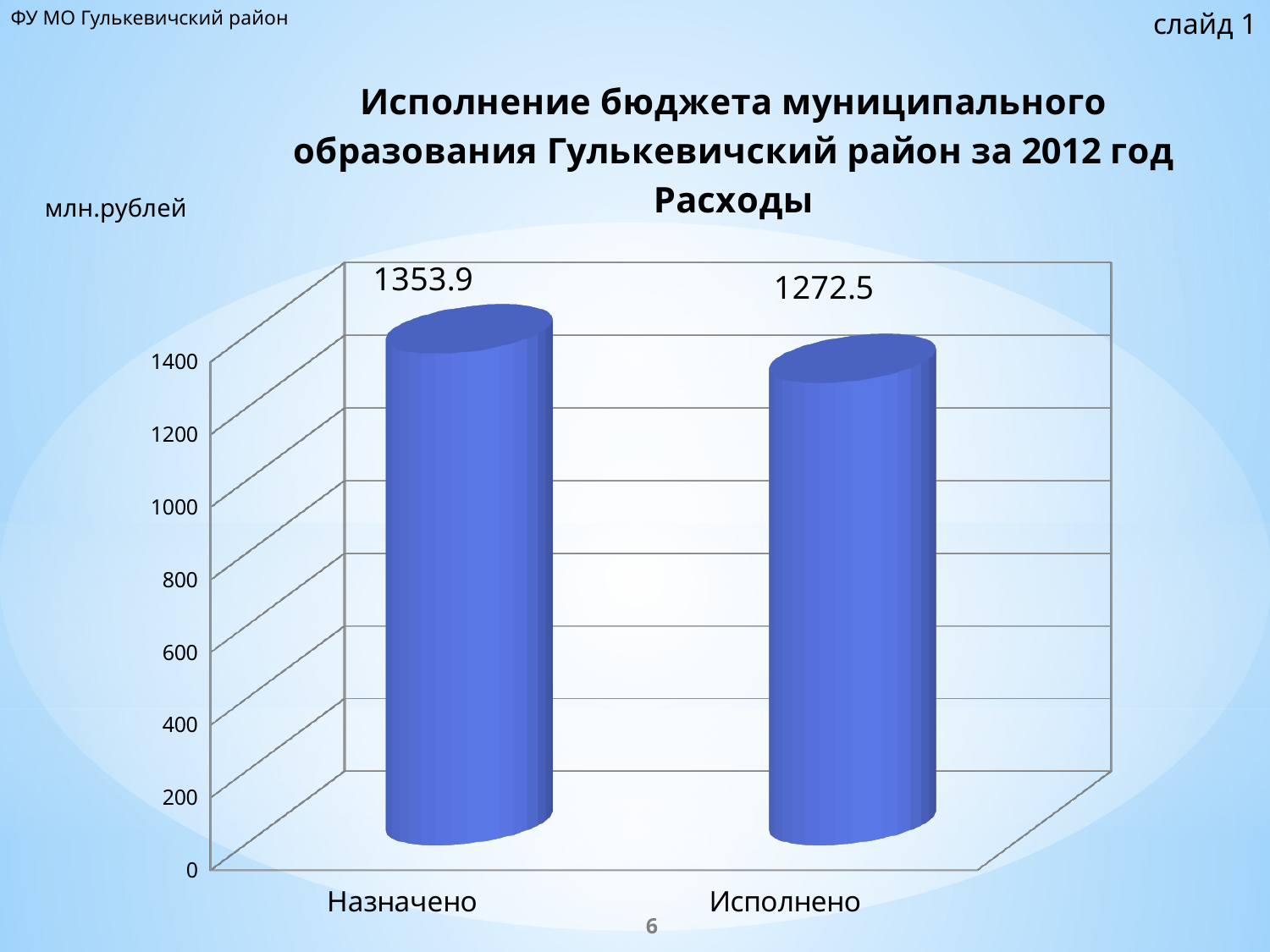
What is the value for Исполнено? 1272.5 Is the value for Исполнено greater or less than 1200? greater What is the difference between the values for Назначено and Исполнено? 81.4 Which is larger, the value for Назначено or the value for Исполнено? Назначено What kind of chart is shown on the slide? bar chart How many categories are shown on the chart? 2 What unit of measurement is indicated for the chart values? млн.рублей What is the value for Назначено? 1353.9 Is the value for Назначено greater or less than 1400? less Do the values rise or fall from Назначено to Исполнено? fall Which category has the lowest value? Исполнено Which category has the highest value? Назначено